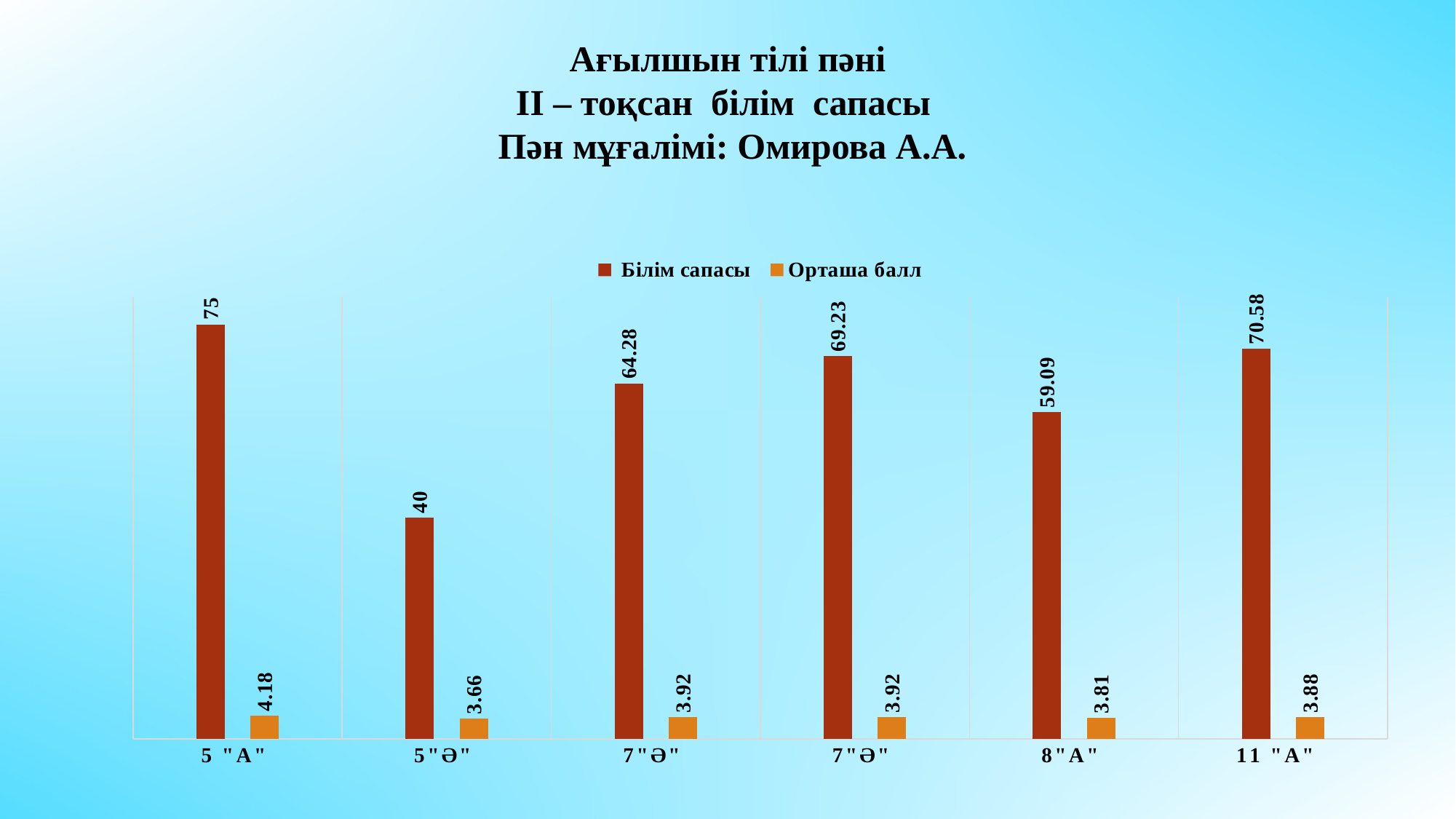
Which class has the lowest Орташа балл value? 5 "Ә" What is the Орташа балл value for 5 "Ә"? 3.66 What is the Орташа балл value for 11 "А"? 3.88 How many classes are shown on the x axis? 6 Which class has the highest Білім сапасы value? 5 "А" What is the Білім сапасы value for 5 "А"? 75 How many series does the legend list? 2 What kind of chart is shown on the slide? Bar chart Which has the larger Білім сапасы value, 8 "А" or 11 "А"? 11 "А" What is the difference between the Білім сапасы values for 5 "А" and 5 "Ә"? 35 Which class has the lowest Білім сапасы value? 5 "Ә" What is the Білім сапасы value for 8 "А"? 59.09